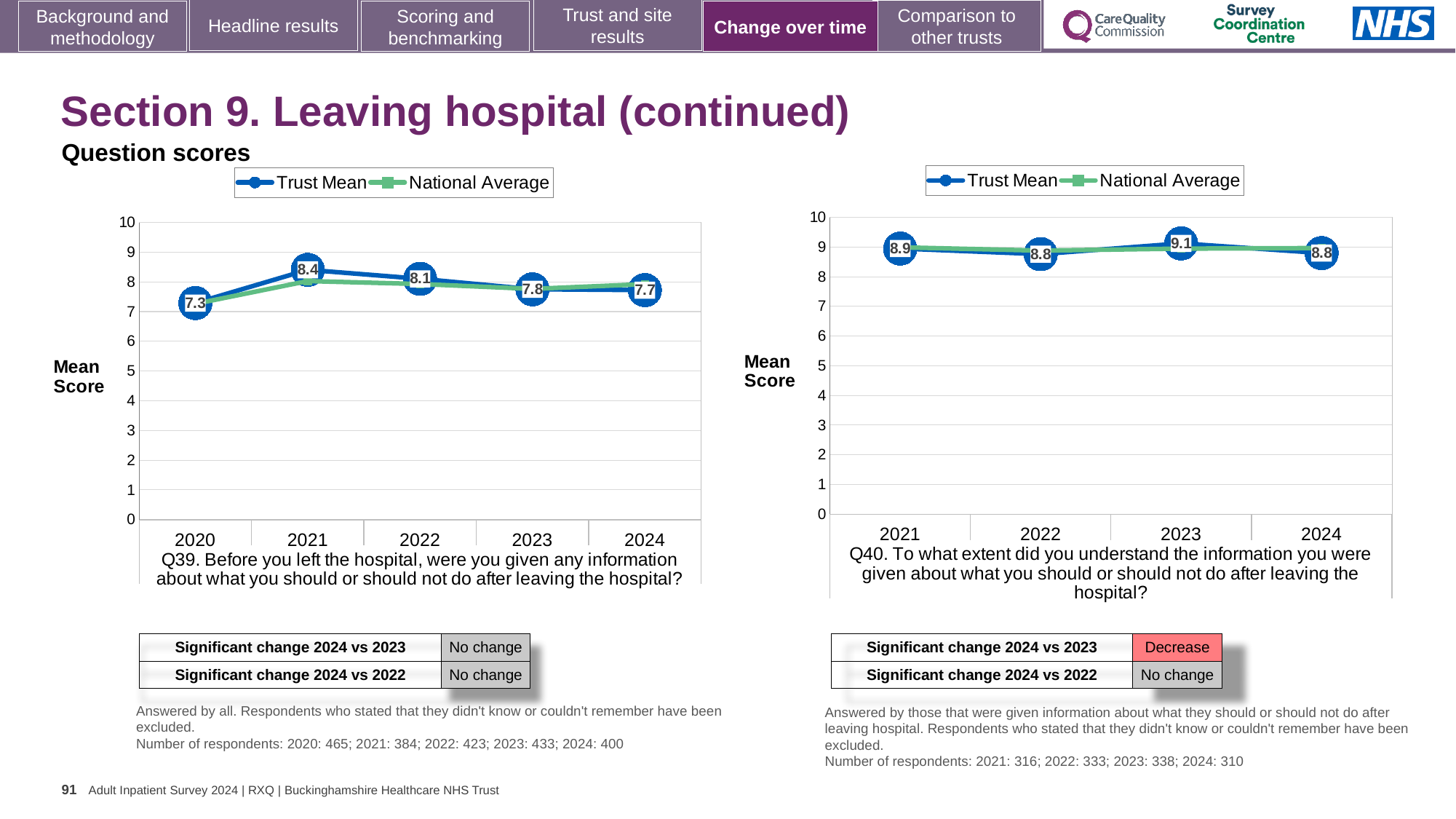
In the Q39 chart on the left, is the Trust Mean score higher in 2022 or 2023? 2022 How many series does the legend of the Q40 chart on the right list? 2 In the Q39 chart on the left, what is the Trust Mean score for 2021? 8.4 In the Q39 chart on the left, does the Trust Mean score rise or fall from 2021 to 2024? fall How many years are plotted in the Q39 chart on the left? 5 In the Q39 chart on the left, which year has the highest Trust Mean score? 2021 What kind of chart is the Q39 chart on the left? line chart In the Q39 chart on the left, which year has the lowest Trust Mean score? 2020 In the Q40 chart on the right, which year has the highest Trust Mean score? 2023 In the Q40 chart on the right, what is the difference between the Trust Mean scores for 2023 and 2024? 0.3 In the Q40 chart on the right, what is the Trust Mean score for 2023? 9.1 In the Q39 chart on the left, what is the difference between the Trust Mean scores for 2021 and 2024? 0.7